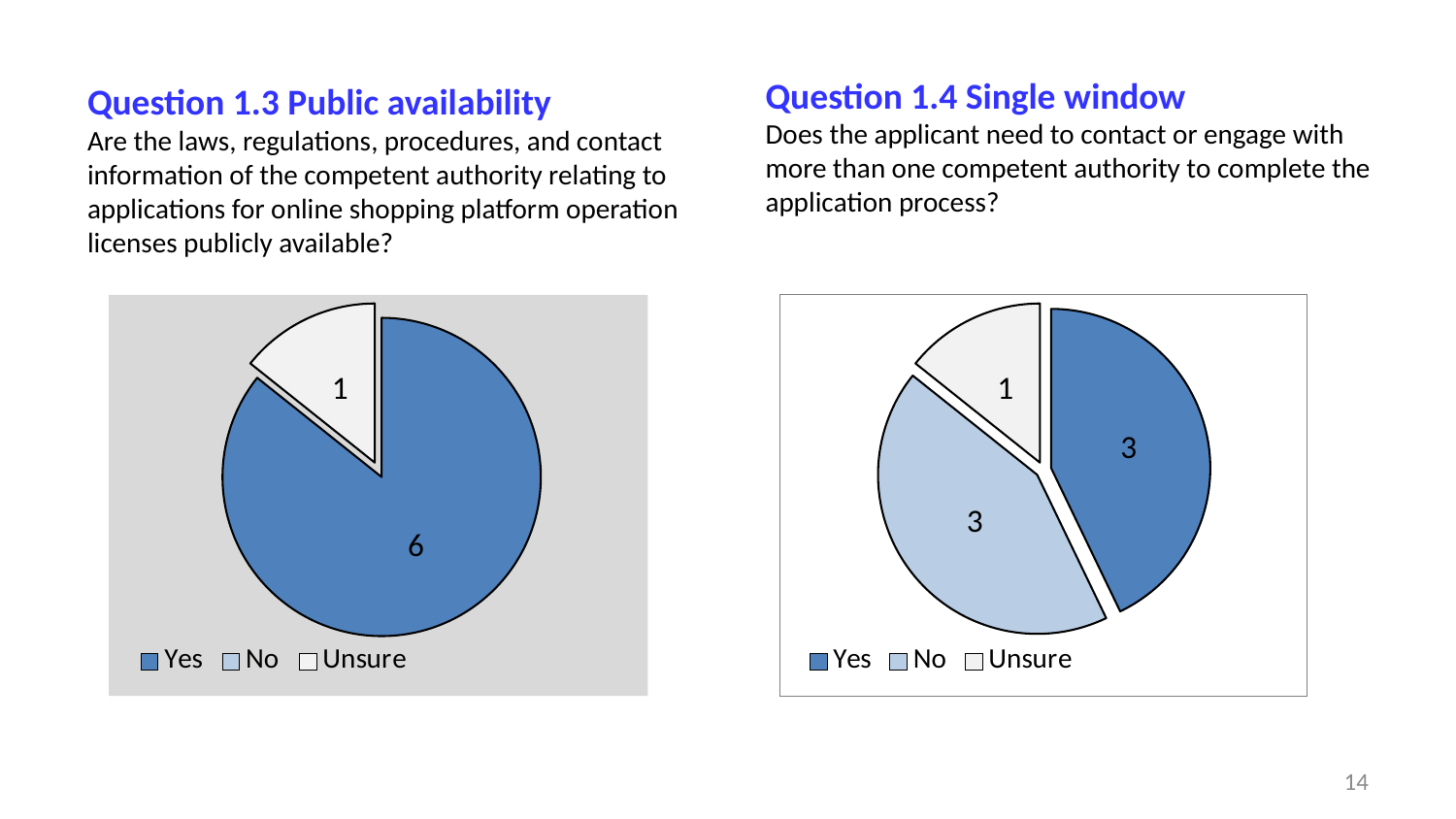
In the Question 1.3 Public availability chart, what is the difference between the Yes and Unsure values? 5 In the Question 1.4 Single window chart, what value is shown for Unsure? 1 In the Question 1.3 Public availability chart, which response has the largest slice? Yes In the Question 1.4 Single window chart, what is the difference between the Yes and Unsure values? 2 In the Question 1.4 Single window chart, what is the total of all the labelled slices? 7 In the Question 1.4 Single window chart, what value is shown for No? 3 In the Question 1.3 Public availability chart, what value is shown for Unsure? 1 What type of chart is used for Question 1.4 Single window? Pie chart How many entries does the legend of the Question 1.4 Single window chart list? 3 In the Question 1.3 Public availability chart, what value is shown for Yes? 6 In the Question 1.4 Single window chart, which response has the smallest slice? Unsure In the Question 1.3 Public availability chart, which is larger, Yes or Unsure? Yes